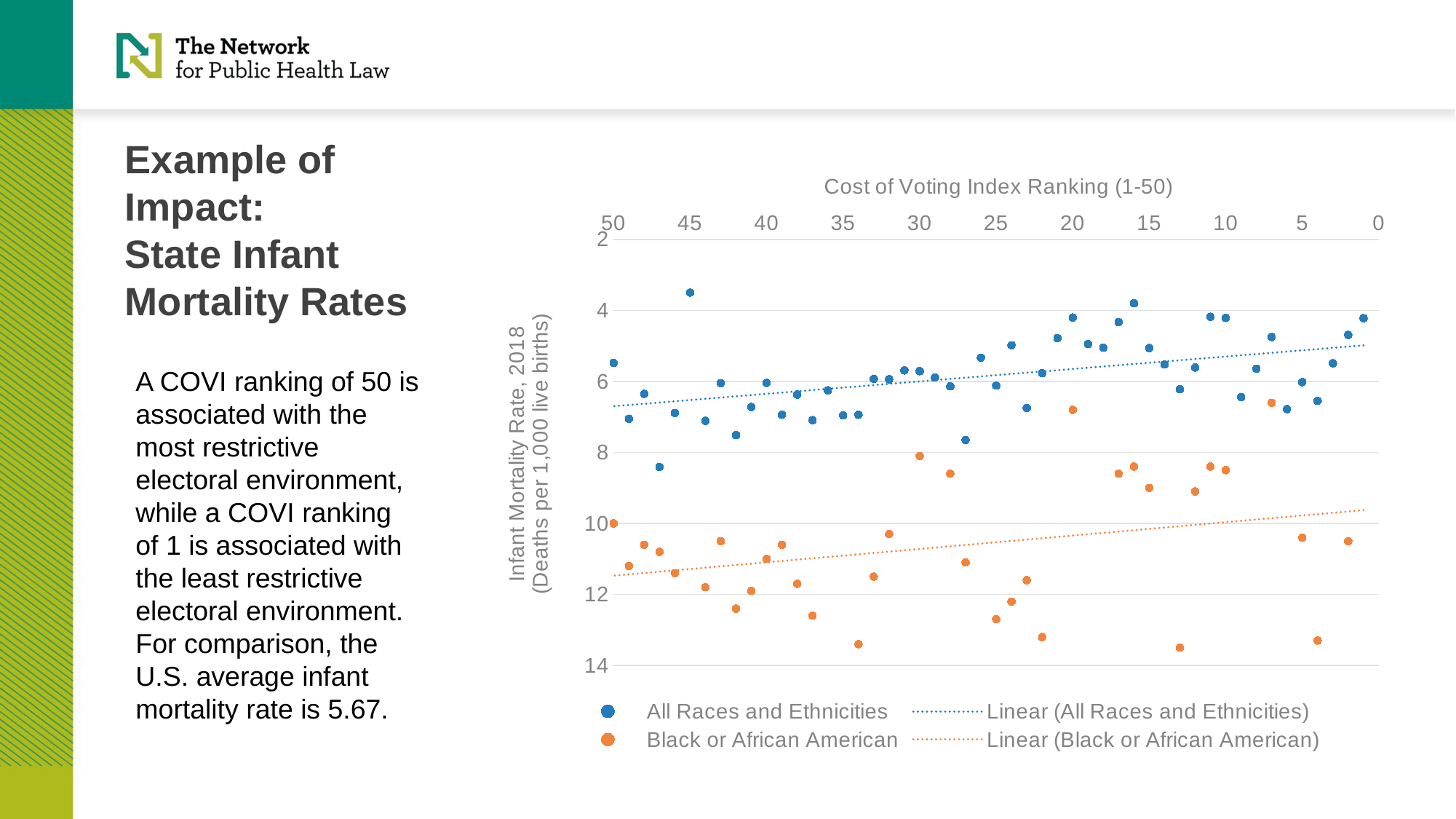
Is the lowest All Races and Ethnicities point on the chart greater or less than 4? less As the Cost of Voting Index Ranking goes from 50 down to 0 along the x axis, does the Linear (All Races and Ethnicities) trendline show the infant mortality rate rising or falling? falling Which series has the lowest infant mortality rate plotted on the chart, All Races and Ethnicities or Black or African American? All Races and Ethnicities What is the title of the horizontal axis of the chart? Cost of Voting Index Ranking (1-50) Which series has the highest infant mortality rate plotted on the chart, All Races and Ethnicities or Black or African American? Black or African American Which series is plotted with orange markers? Black or African American Is the Black or African American value at a Cost of Voting Index Ranking of 50 greater or less than 8? greater How many entries does the chart legend list? 4 What kind of chart is shown on the slide? Scatter chart What is the label of the vertical axis of the chart? Infant Mortality Rate, 2018 (Deaths per 1,000 live births) Which series generally shows higher infant mortality rates, All Races and Ethnicities or Black or African American? Black or African American Is the All Races and Ethnicities value at a Cost of Voting Index Ranking of 50 greater or less than 6? less